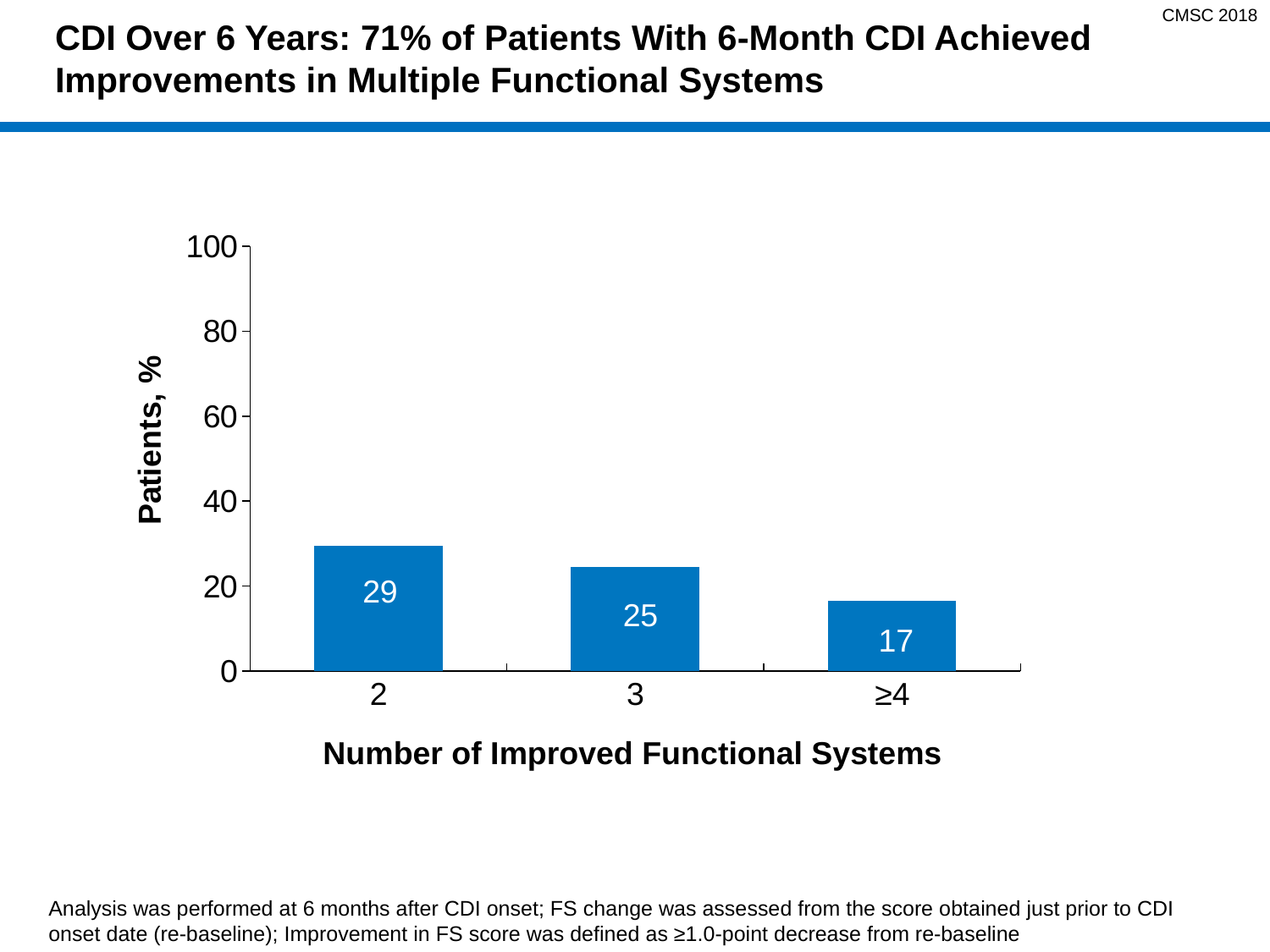
Is the value for 2 improved functional systems greater or less than 20? greater What percentage of patients improved in 2 functional systems? 29 What kind of chart is shown on the slide? bar chart Which has a larger percentage of patients: 3 or ≥4 improved functional systems? 3 What percentage of patients improved in ≥4 functional systems? 17 Which number of improved functional systems has the highest percentage of patients? 2 Which number of improved functional systems has the lowest percentage of patients? ≥4 What percentage of patients improved in 3 functional systems? 25 How many categories are shown on the x axis? 3 What is the label of the y axis? Patients, % What is the difference in percentage of patients between 2 and 3 improved functional systems? 4 What is the difference in percentage of patients between 2 and ≥4 improved functional systems? 12